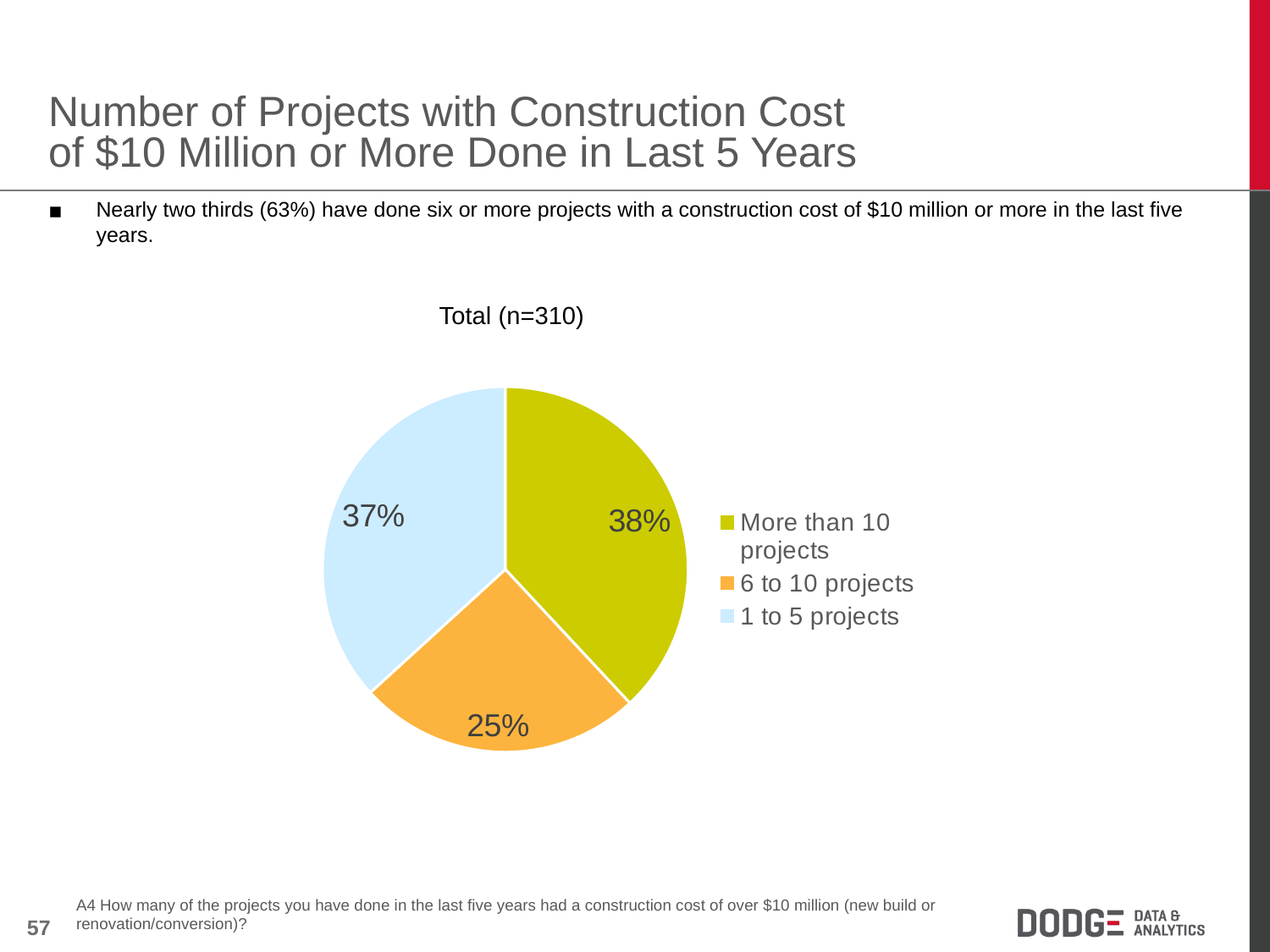
What is the combined share of 'More than 10 projects' and '6 to 10 projects'? 63% What is the title shown above the pie chart? Total (n=310) What is the difference in percentage points between 'More than 10 projects' and '6 to 10 projects'? 13 percentage points What share of the pie is '1 to 5 projects'? 37% How many slices does the pie chart have? 3 How many entries does the legend list? 3 Which is larger, the share for '1 to 5 projects' or the share for '6 to 10 projects'? 1 to 5 projects What is the difference in percentage points between '1 to 5 projects' and '6 to 10 projects'? 12 percentage points Which category has the smallest slice of the pie? 6 to 10 projects What share of the pie is '6 to 10 projects'? 25% What kind of chart is shown on the slide? pie chart What share of the pie is 'More than 10 projects'? 38%